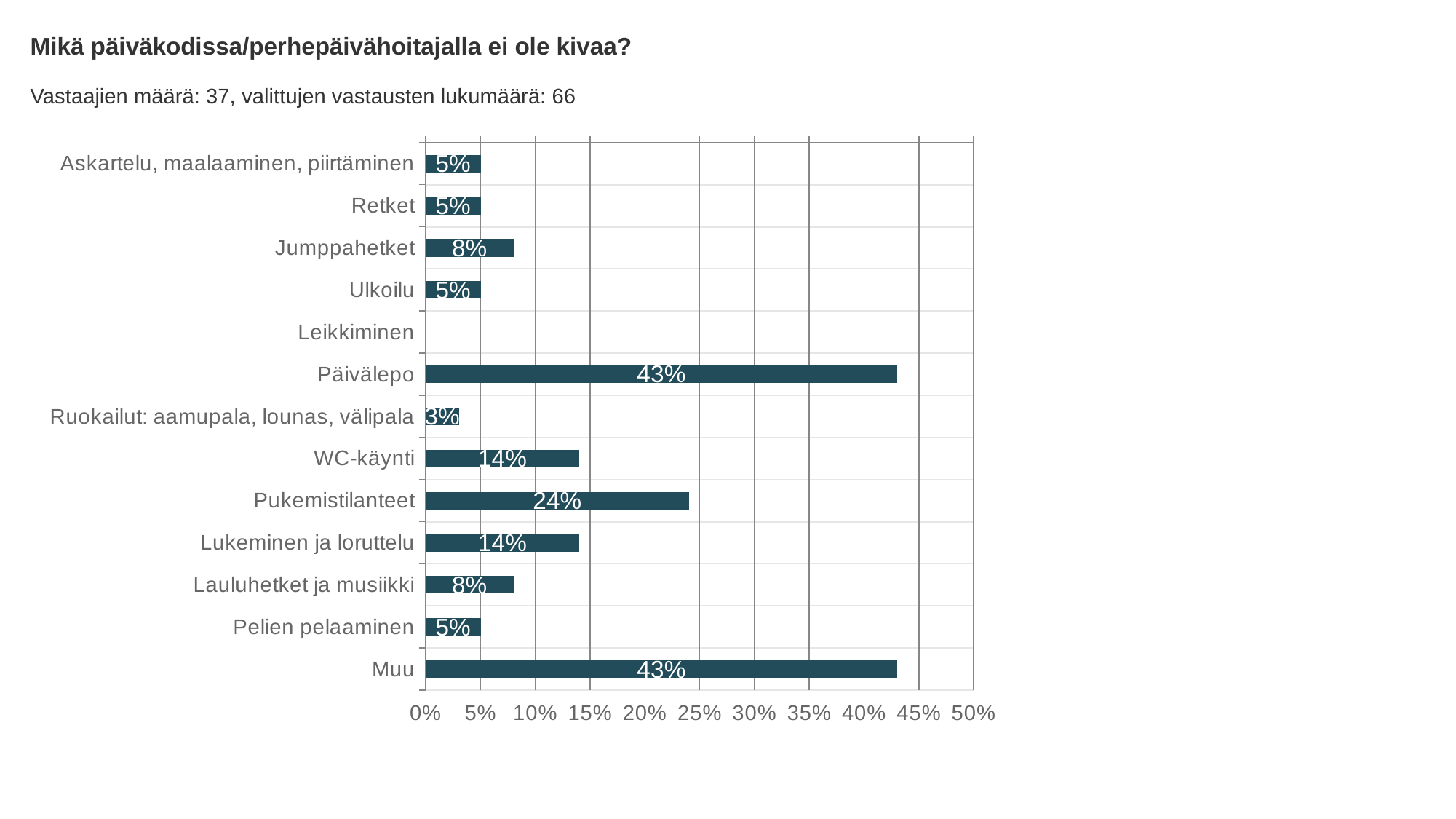
What is the value for WC-käynti? 14% What is the title of the chart? Mikä päiväkodissa/perhepäivähoitajalla ei ole kivaa? What is the difference between the values for WC-käynti and Lauluhetket ja musiikki? 6% Is the value for Muu greater or less than 40%? greater What is the value for Pukemistilanteet? 24% What is the value for Päivälepo? 43% What kind of chart is shown on the slide? Bar chart How many categories are shown on the chart? 13 What is the difference between the values for Päivälepo and Pukemistilanteet? 19% What is the value for Ruokailut: aamupala, lounas, välipala? 3% What is the value for Jumppahetket? 8% Which is larger, the value for Pukemistilanteet or the value for Lukeminen ja loruttelu? Pukemistilanteet